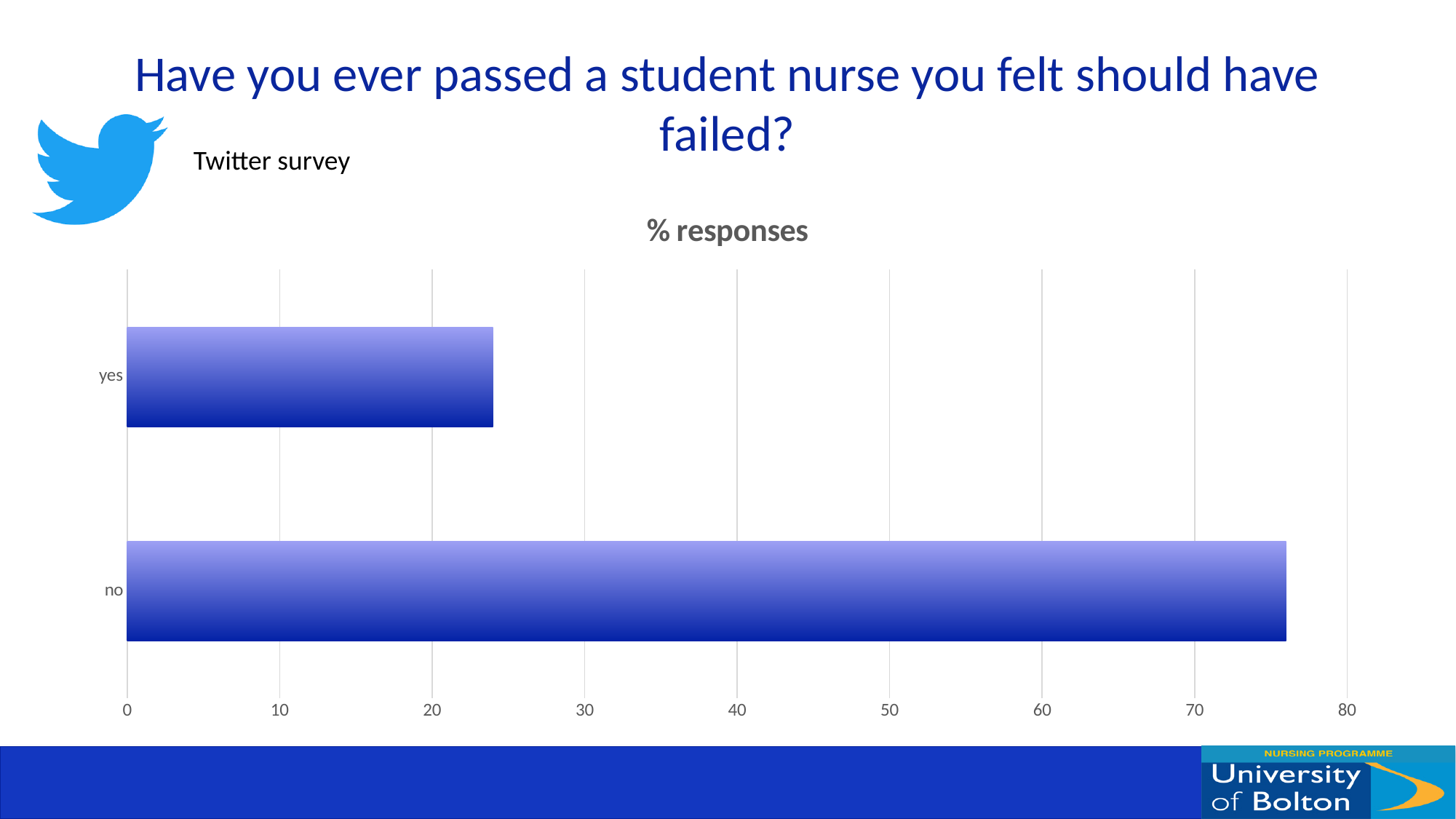
Is the value for no greater or less than 70? greater What is the title of the chart? % responses Is the value for yes greater or less than 20? greater Which category has the highest value in the chart? no What kind of chart is shown on the slide? bar chart What is the highest value shown on the horizontal axis of the chart? 80 Is the value for yes greater or less than 30? less Which category has the lowest value in the chart? yes How many categories are plotted in the chart? 2 Which is larger, the value for yes or the value for no? no